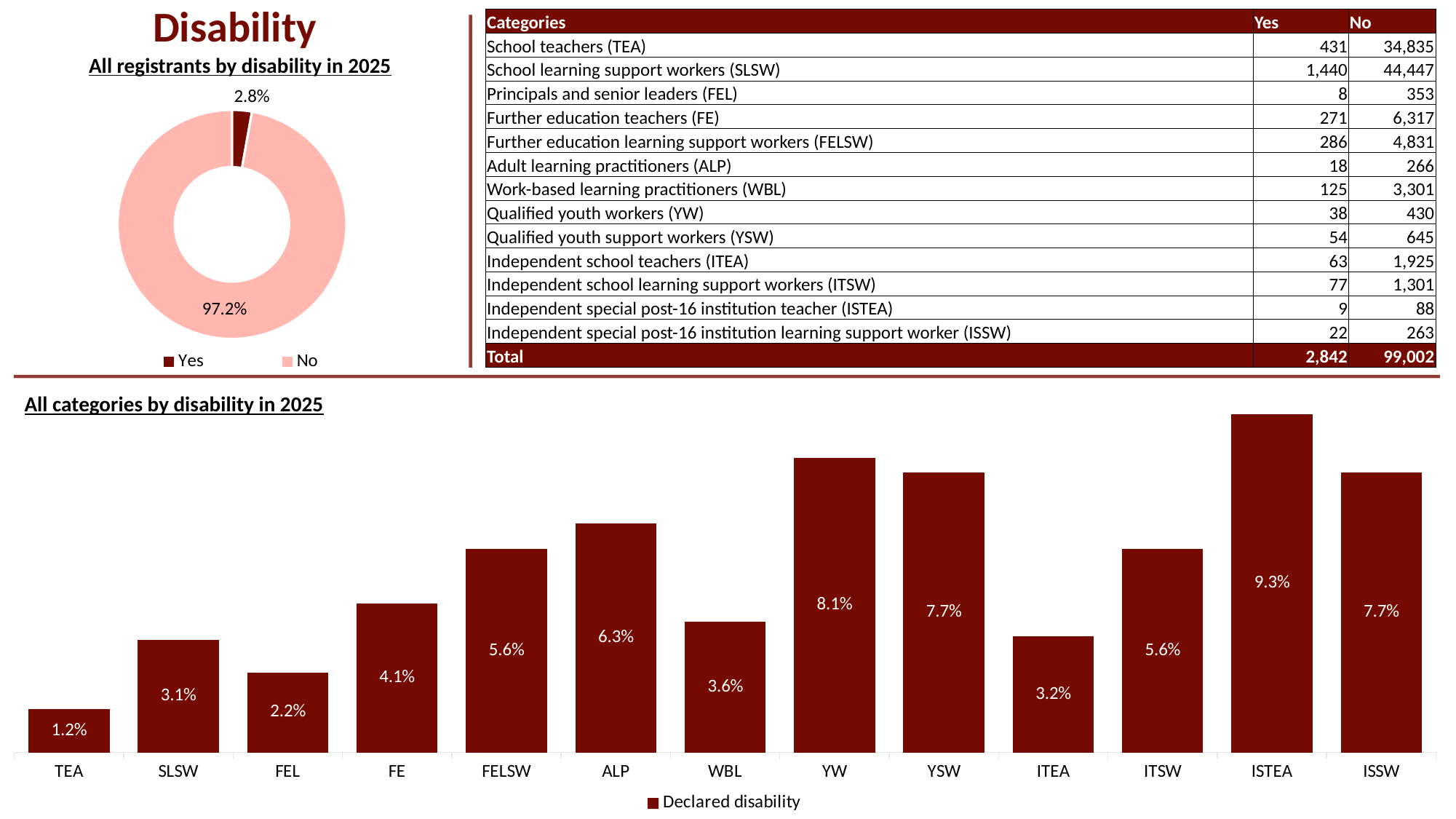
In the 'All categories by disability in 2025' chart, which is larger, the value for ALP or the value for FE? ALP In the 'All categories by disability in 2025' chart, what is the difference between the values for YW and WBL? 4.5% In the 'All categories by disability in 2025' chart, what is the value for TEA? 1.2% In the 'All categories by disability in 2025' chart, which category has the lowest value? TEA In the 'All categories by disability in 2025' chart, which category has the highest value? ISTEA In the 'All registrants by disability in 2025' chart, what share of registrants declared a disability (Yes)? 2.8% In the 'All categories by disability in 2025' chart, what is the value for ISTEA? 9.3% In the 'All registrants by disability in 2025' chart, what share of registrants is shown for No? 97.2% What kind of chart is 'All registrants by disability in 2025'? Pie (doughnut) chart What kind of chart is 'All categories by disability in 2025'? Bar chart How many series does the legend of the 'All registrants by disability in 2025' chart list? 2 How many categories are shown on the x axis of the 'All categories by disability in 2025' chart? 13